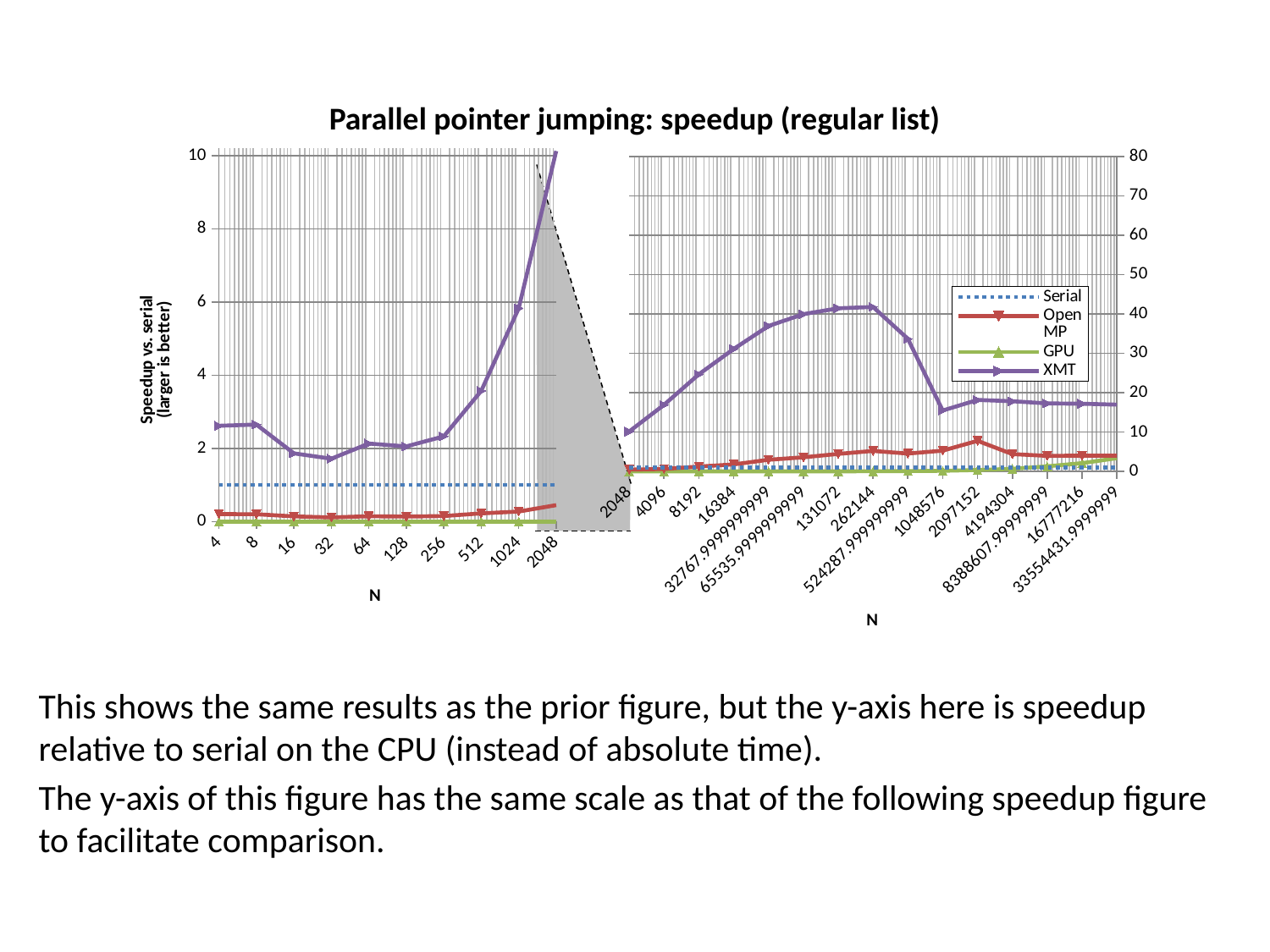
In the left panel, does the XMT series rise or fall from N = 512 to N = 2048? rise What kind of chart is shown on the slide? line chart In the left panel, is the XMT value at N = 2048 greater or less than 8? greater In the right panel, which series reaches the highest speedup? XMT Which series are listed in the legend? Serial, Open MP, GPU, XMT In the left panel, is the XMT value at N = 4 greater or less than 2? greater How many series does the legend list? 4 What is the title of the chart on the slide? Parallel pointer jumping: speedup (regular list) In the right panel, is the XMT value at N = 262144 greater or less than 30? greater In the right panel (N from 2048 upward), how many N values are plotted along the x axis? 15 In the left panel (N from 4 to 2048), how many N values are plotted along the x axis? 10